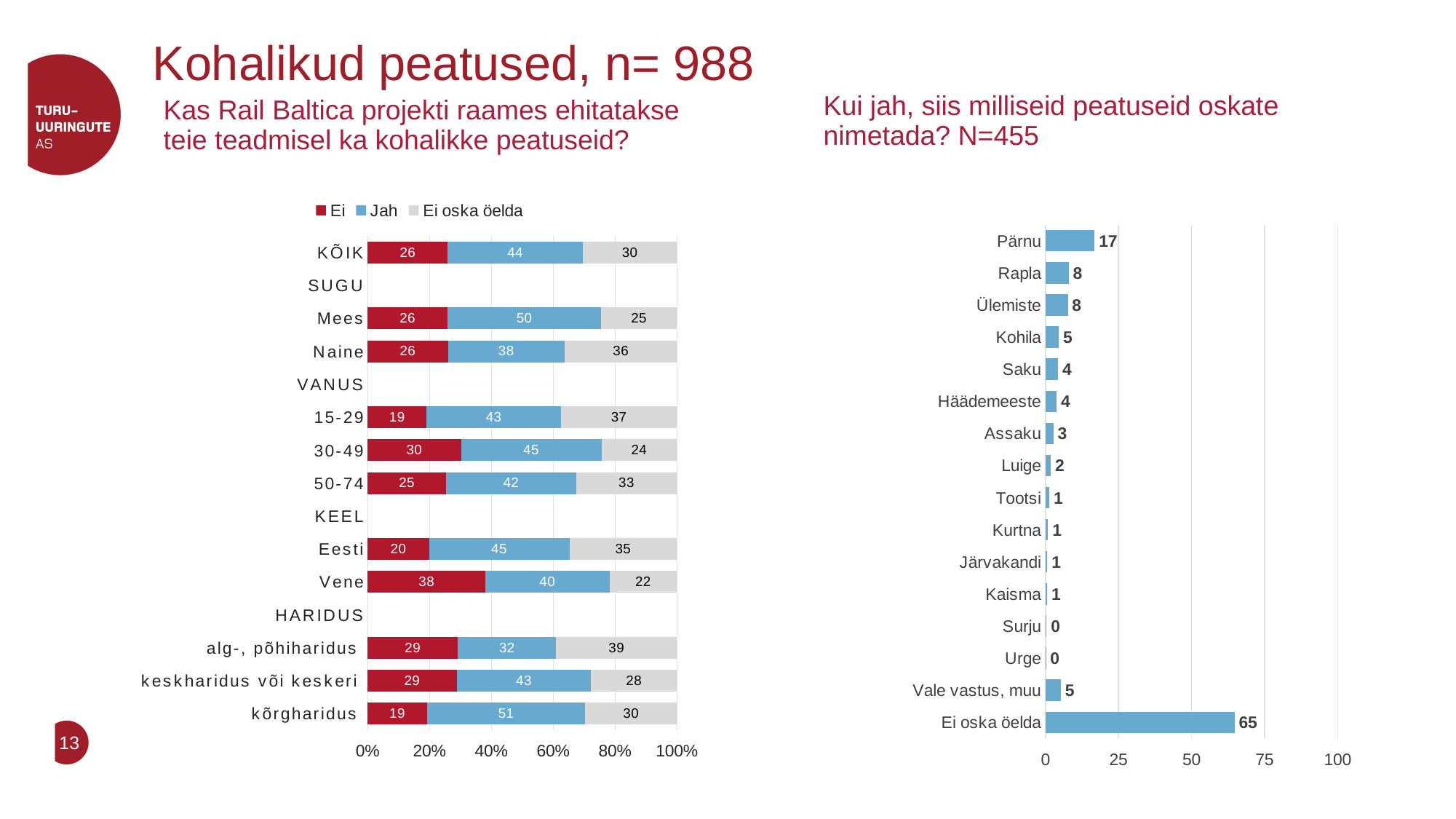
In the right chart, what is the value for Pärnu? 17 In the left chart, what is the 'Ei' value for Vene? 38 In the left chart, what is the 'Ei oska öelda' value for alg-, põhiharidus? 39 In the right chart, what is the difference between the values for Ei oska öelda and Pärnu? 48 In the left chart, what is the difference between the 'Jah' values for Mees and Naine? 12 In the left chart, what is the 'Jah' value for Mees? 50 In the right chart, how many categories are shown? 16 In the left chart, which is larger: the 'Ei' value for 30-49 or for 15-29? 30-49 How many series does the legend of the left chart list? 3 In the right chart, which category has the highest value? Ei oska öelda What kind of chart is the right chart? bar chart In the left chart, which category has the highest 'Jah' value? kõrgharidus